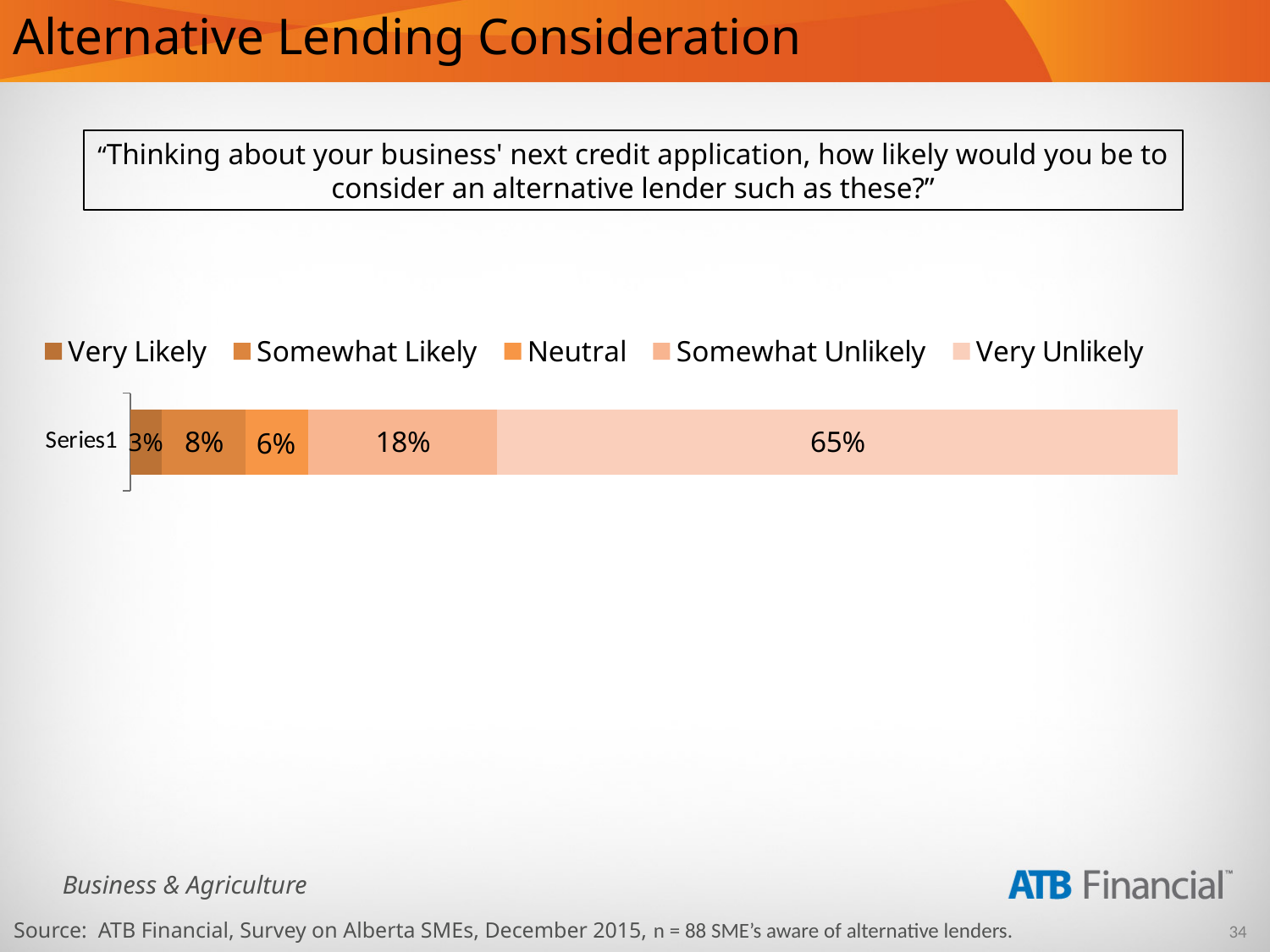
What kind of chart is shown on the slide? Stacked bar chart What percentage of respondents answered Somewhat Likely? 8% How many series does the legend list? 5 What is the combined percentage of Very Likely and Somewhat Likely responses? 11% Which response category has the smallest share? Very Likely What percentage of respondents answered Neutral? 6% What is the difference between the Very Unlikely and Somewhat Unlikely percentages? 47% Which is larger, the Somewhat Likely share or the Neutral share? Somewhat Likely Which response category has the largest share? Very Unlikely What percentage of respondents answered Somewhat Unlikely? 18% What percentage of respondents said they would be Very Unlikely to consider an alternative lender? 65% What percentage of respondents answered Very Likely? 3%